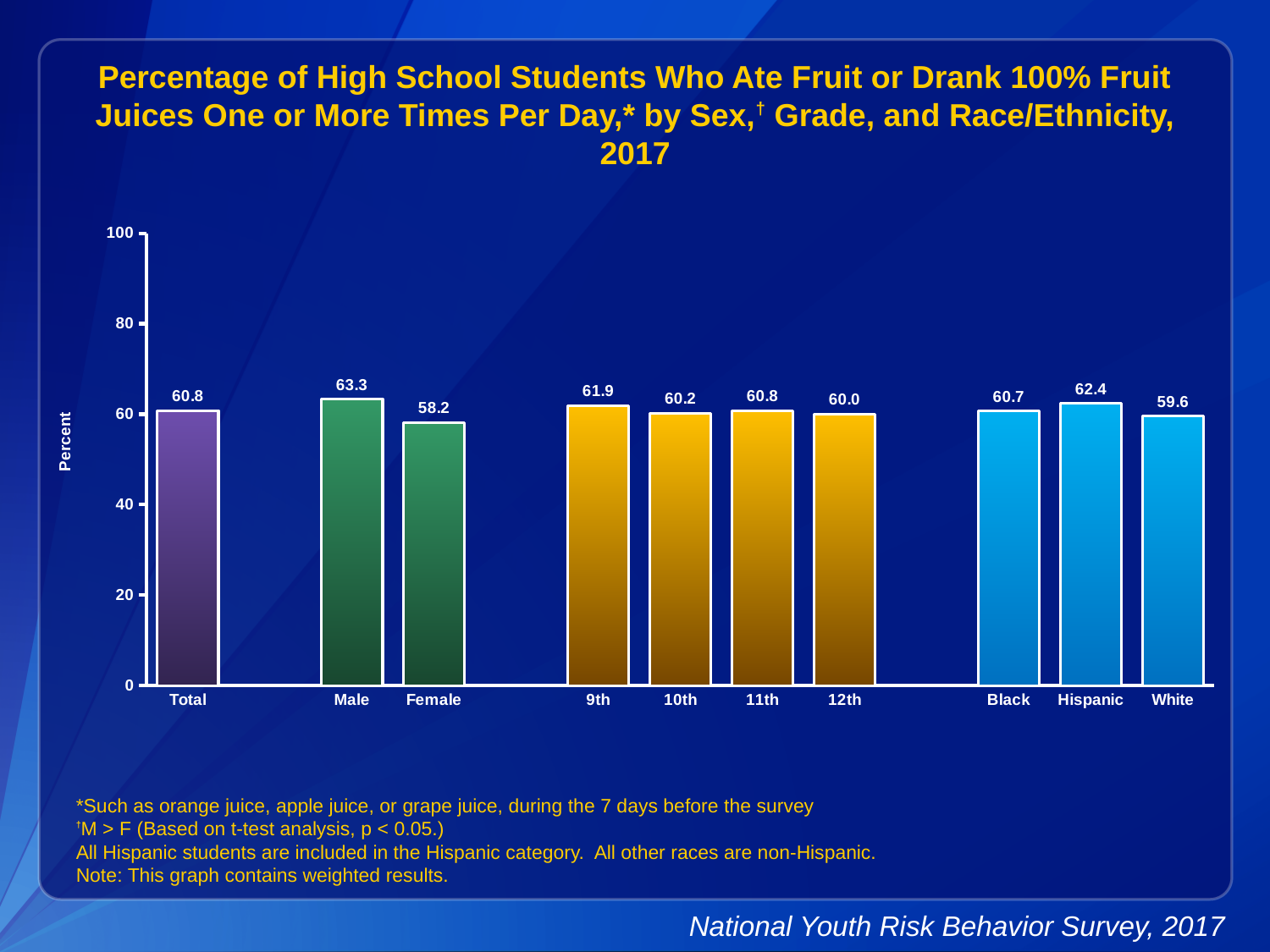
Which category has the lowest value? Female Which is larger, the value for 9th or the value for 12th? 9th What is the label of the y axis? Percent What is the value for Female? 58.2 Is the value for White greater or less than 80? less How many categories are shown on the x axis? 10 Which category has the highest value? Male Do the values rise or fall from 9th grade to 12th grade? fall What is the value for Hispanic? 62.4 What is the difference between the values for Male and Female? 5.1 What is the value for Total? 60.8 What kind of chart is this? bar chart